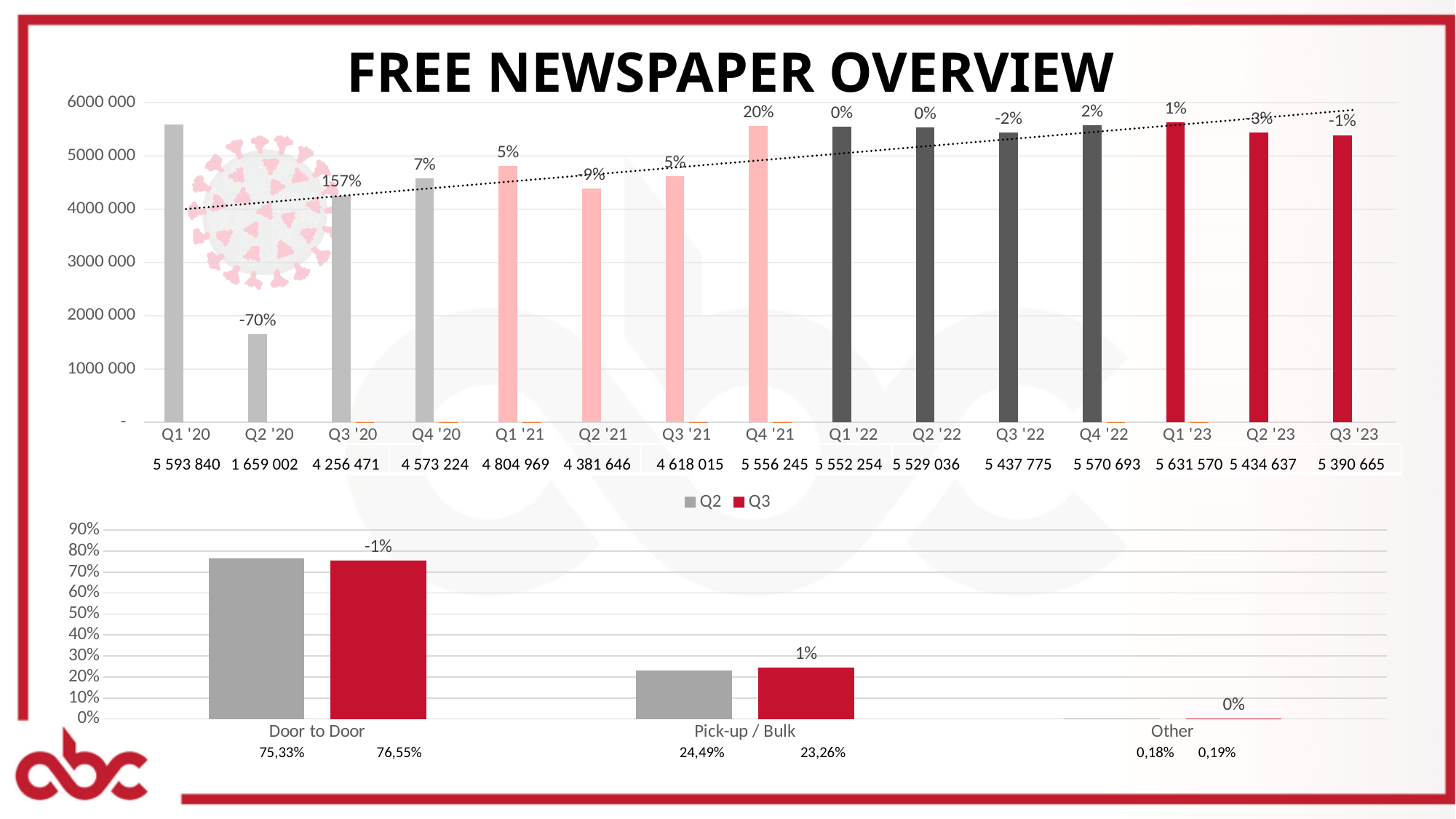
How many quarters are shown on the x axis of the top chart? 15 In the top chart, what percentage change is labelled above the Q3 '20 bar? 157% How many series does the legend of the bottom chart list? 2 In the top chart, what is the difference between the values for Q1 '23 and Q3 '23? 240 905 In the top chart, which quarter has the lowest value? Q2 '20 What kind of chart is the bottom chart? Bar chart In the top chart, what is the value for Q3 '23? 5 390 665 In the top chart, what is the value for Q2 '20? 1 659 002 In the top chart, which quarter has the highest value? Q1 '23 In the top chart, which is larger, the value for Q4 '21 or the value for Q2 '21? Q4 '21